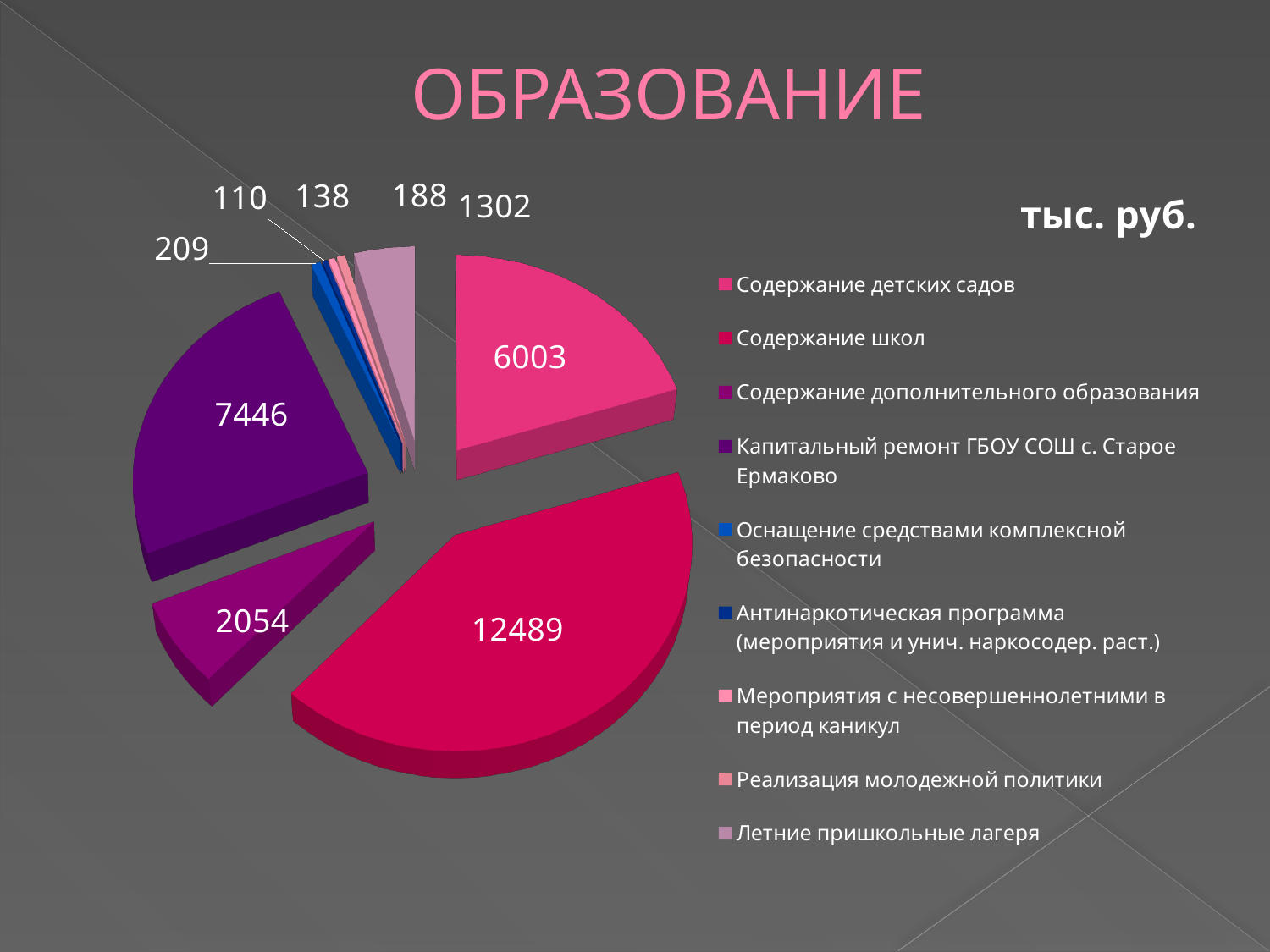
In what units are the values on the chart given? тыс. руб. What is the title of the chart on the slide? тыс. руб. What is the difference between the values for Содержание школ and Капитальный ремонт ГБОУ СОШ с. Старое Ермаково? 5043 What is the value for Содержание детских садов? 6003 Which category has the largest slice of the pie? Содержание школ What is the value for Содержание школ? 12489 What is the value for Летние пришкольные лагеря? 1302 Which is larger: the value for Содержание дополнительного образования or the value for Летние пришкольные лагеря? Содержание дополнительного образования What kind of chart is shown on the slide? pie chart What is the value for Капитальный ремонт ГБОУ СОШ с. Старое Ермаково? 7446 How many categories does the legend of the pie chart list? 9 Which category has the smallest slice of the pie? Антинаркотическая программа (мероприятия и унич. наркосодер. раст.)